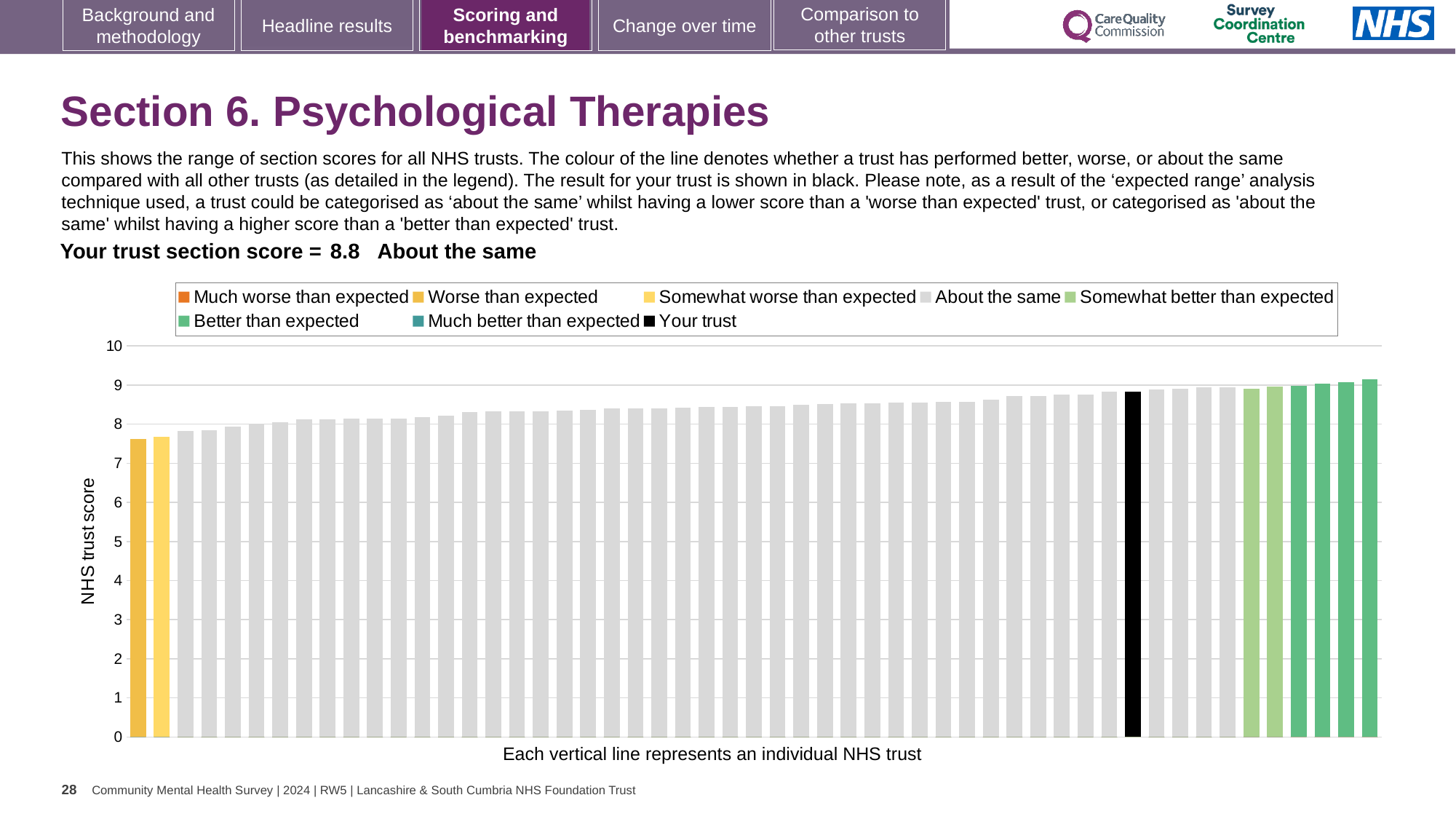
Which performance category is your trust placed in for Section 6? About the same What is the label on the vertical axis of the chart? NHS trust score Is the value of the lowest bar in the chart greater or less than 8? less Which is larger: the score for your trust or the score of the leftmost bar? your trust Which legend category does the highest bar in the chart belong to? Better than expected What kind of chart is shown on the slide? bar chart How many entries does the chart legend list? 8 How many bars are coloured as 'Worse than expected' (yellow)? 1 Do the bar values rise or fall from left to right along the x axis? rise What is the section score for your trust shown on the slide? 8.8 What colour is the bar representing your trust? black Is the value for your trust (the black bar) greater or less than 8? greater